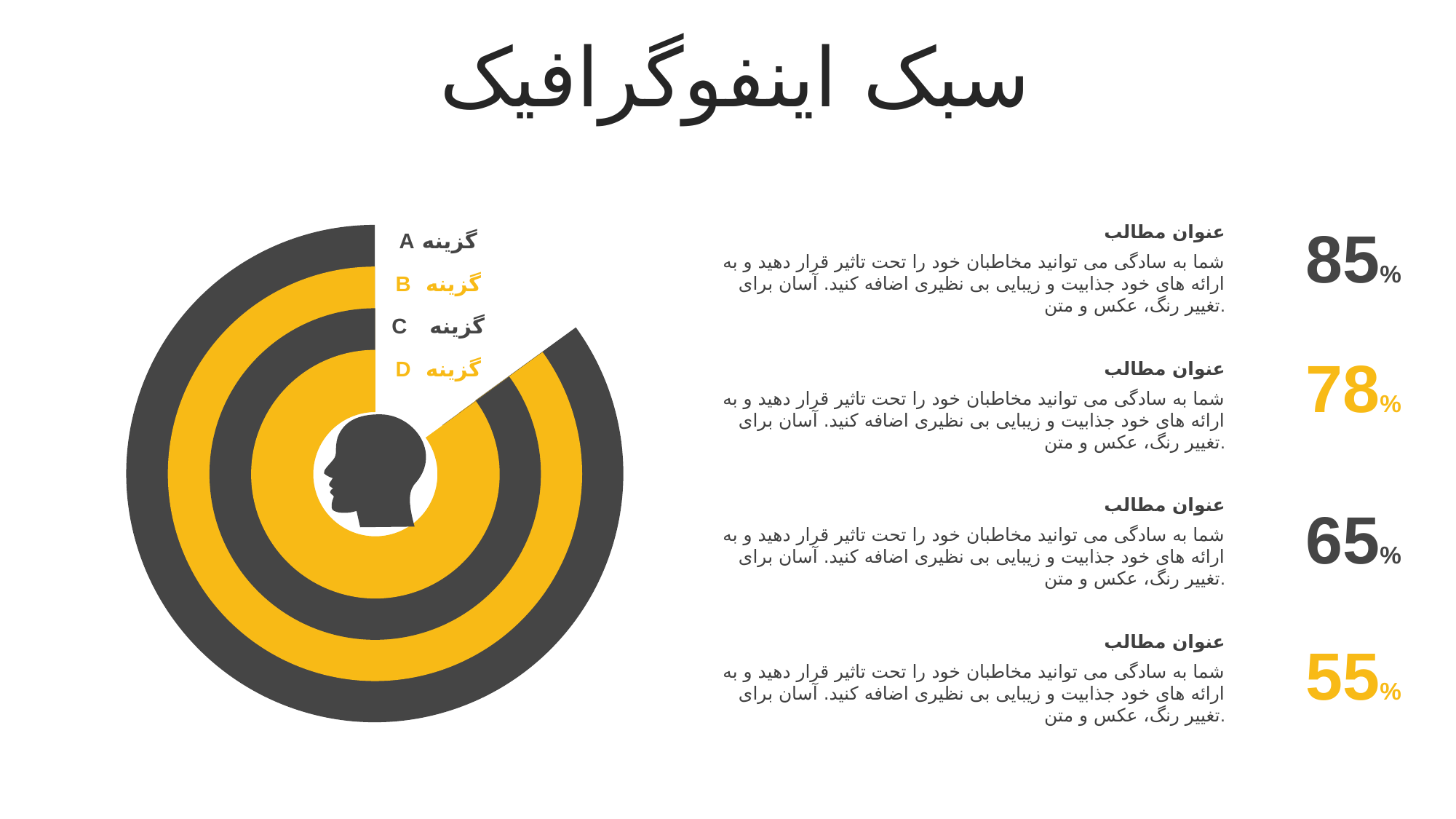
How many labelled options (گزینه) does the ring chart list? 4 Which is larger, the second percentage (78%) or the third percentage (65%) listed on the right? 78% What colour is the label for گزینه B in the ring chart? Yellow What colour is the outermost ring of the chart? Dark grey What kind of chart is shown on the left of the slide? Doughnut (concentric ring) chart What is the smallest percentage printed on the slide? 55% What is the largest percentage printed on the slide? 85% What is the difference between the largest and smallest percentages printed on the slide? 30% Do the percentages listed on the right rise or fall from top to bottom? fall How many percentage values are printed on the right side of the slide? 4